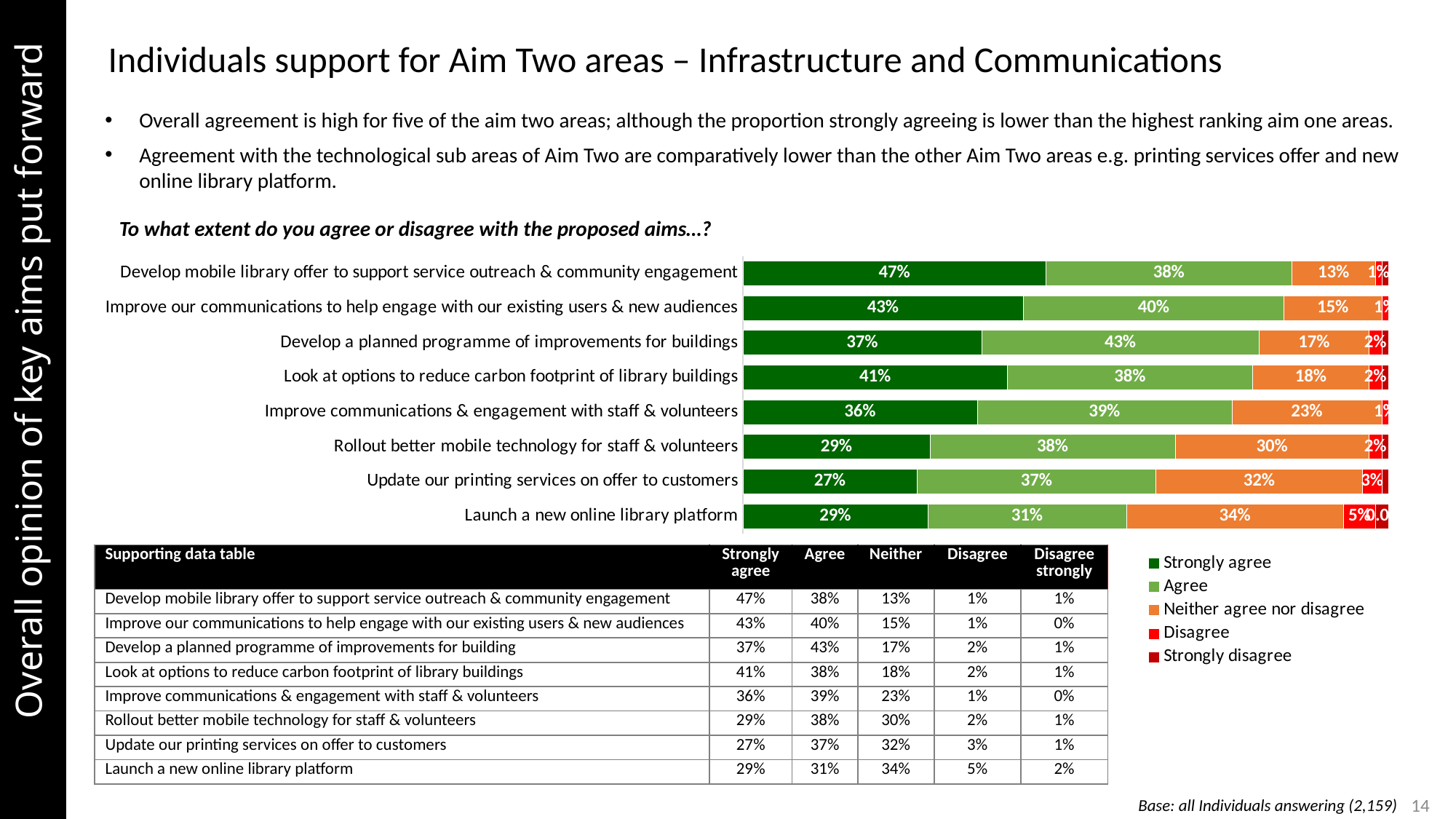
What is the 'Neither agree nor disagree' value for 'Launch a new online library platform'? 34% For 'Develop a planned programme of improvements for buildings', how much larger is the 'Agree' value than the 'Strongly agree' value? 6% What is the 'Agree' value for 'Improve our communications to help engage with our existing users & new audiences'? 40% How many series does the legend list? 5 Which aim has the lowest 'Strongly agree' percentage? Update our printing services on offer to customers Which aim has the highest 'Neither agree nor disagree' percentage? Launch a new online library platform What type of chart is shown on the slide? Stacked bar chart How many aims (bars) are shown in the chart? 8 What percentage strongly agree with 'Develop mobile library offer to support service outreach & community engagement'? 47% Which aim has the highest 'Strongly agree' percentage? Develop mobile library offer to support service outreach & community engagement Which has a higher 'Strongly agree' value: 'Look at options to reduce carbon footprint of library buildings' or 'Improve communications & engagement with staff & volunteers'? Look at options to reduce carbon footprint of library buildings What colour represents 'Strongly agree' in the legend? Dark green